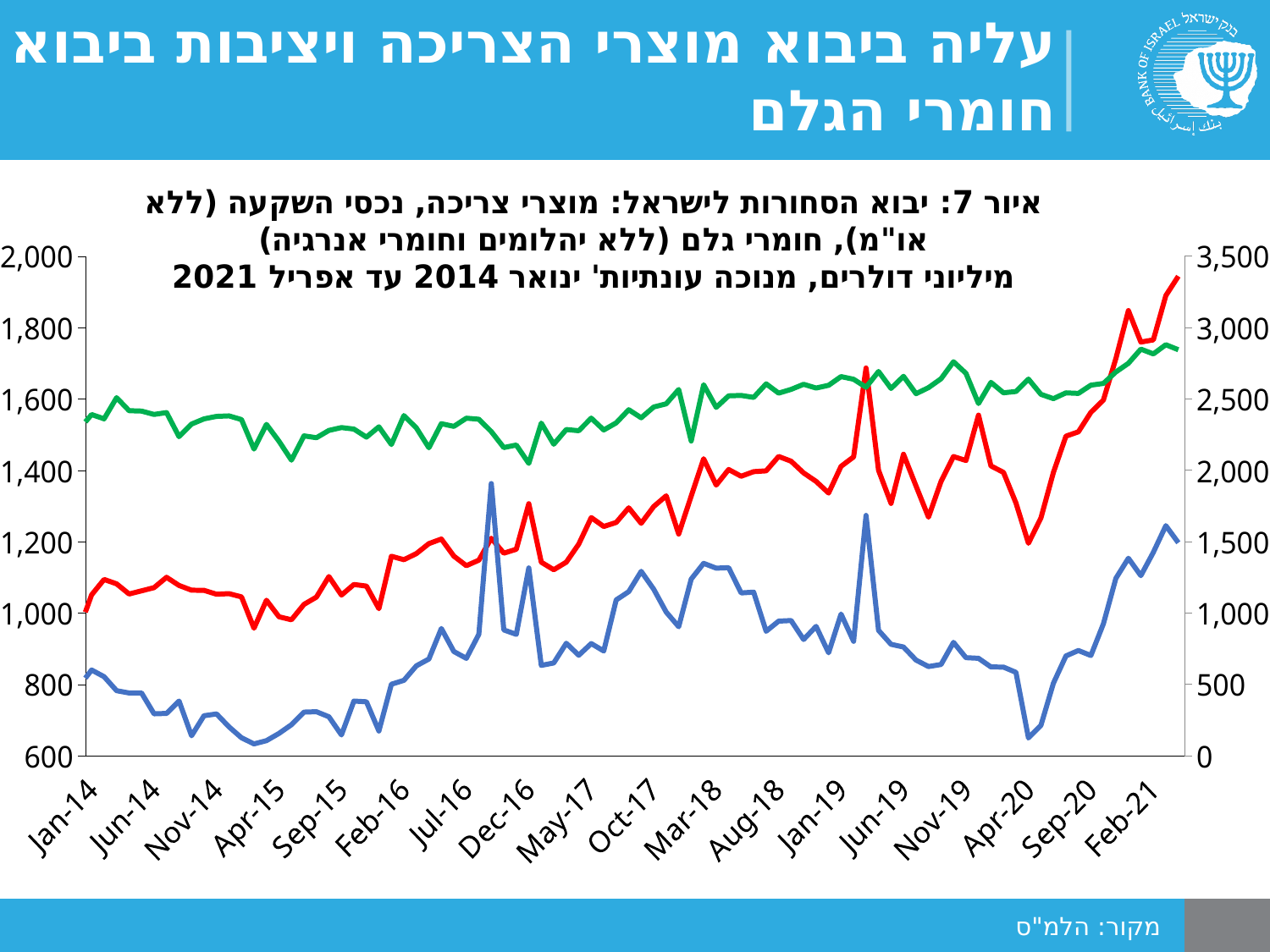
What is the highest value shown on the left-hand y-axis? 2,000 What source is cited at the bottom of the slide? הלמ"ס How many lines are plotted on the chart? 3 Does the blue line end higher or lower at Feb-21 than it started at Jan-14? higher Which line reaches the highest point on the chart at the far right (Feb-21 onward): red, green or blue? red What kind of chart is shown on the slide? line chart What is the last x-axis label on the chart? Feb-21 What is the highest value shown on the right-hand y-axis? 3,500 What is the first x-axis label on the chart? Jan-14 Does the red line rise or fall overall from Jan-14 to Feb-21? rise Which line is lowest on the chart throughout the period: red, green or blue? blue What is the lowest value shown on the left-hand y-axis? 600